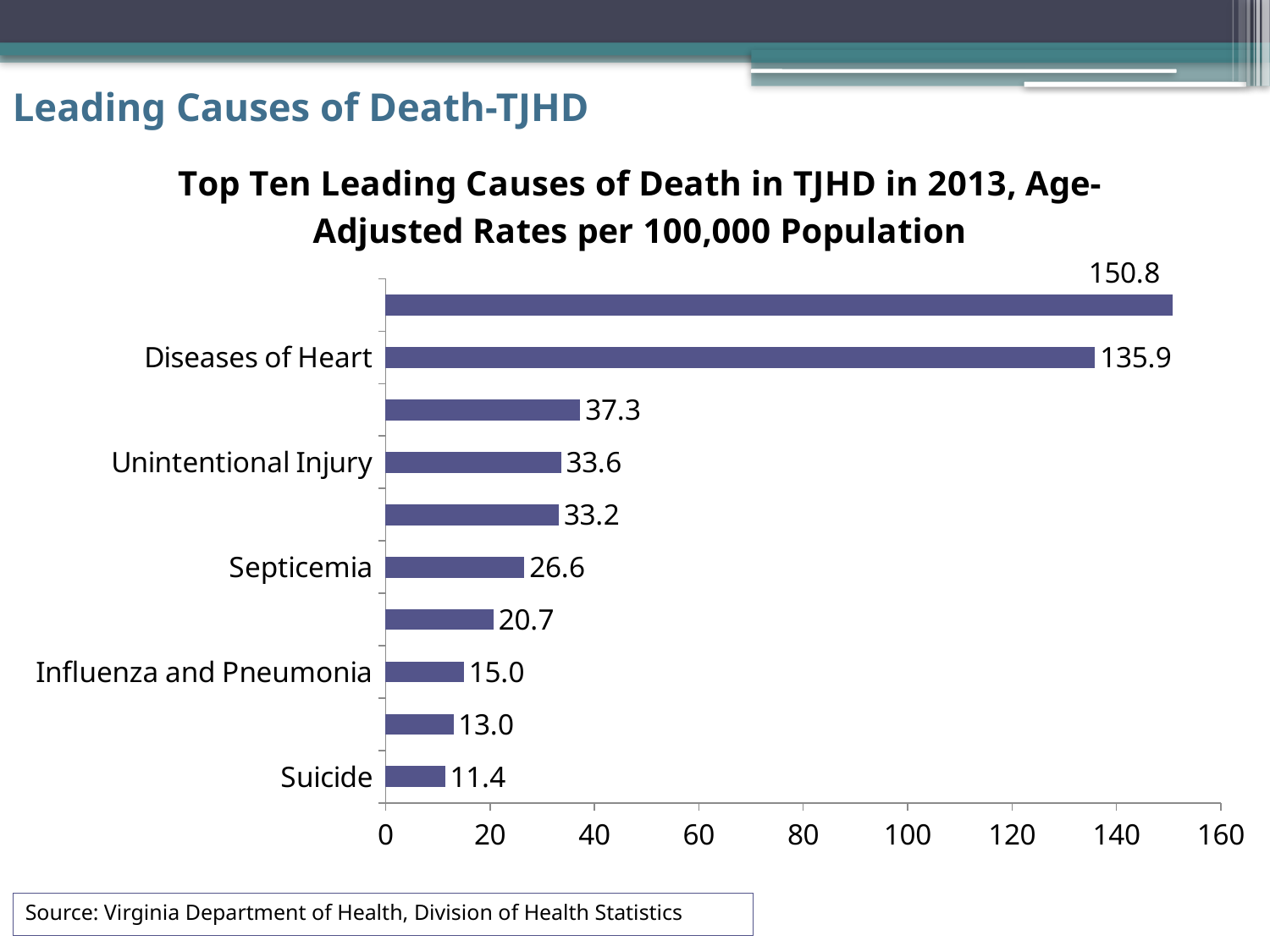
What is the largest value shown on the chart? 150.8 Which has a higher rate, Septicemia or Suicide? Septicemia What is the difference between the rates for Septicemia and Influenza and Pneumonia? 11.6 What is the difference between the rates for Diseases of Heart and Unintentional Injury? 102.3 What is the value shown for Suicide? 11.4 What is the value shown for Unintentional Injury? 33.6 What is the value shown for Influenza and Pneumonia? 15.0 What is the value shown for Septicemia? 26.6 Which labeled cause of death has the lowest rate on the chart? Suicide How many bars are plotted on the chart? 10 Is the value for Diseases of Heart greater or less than 120? greater What is the age-adjusted death rate for Diseases of Heart? 135.9